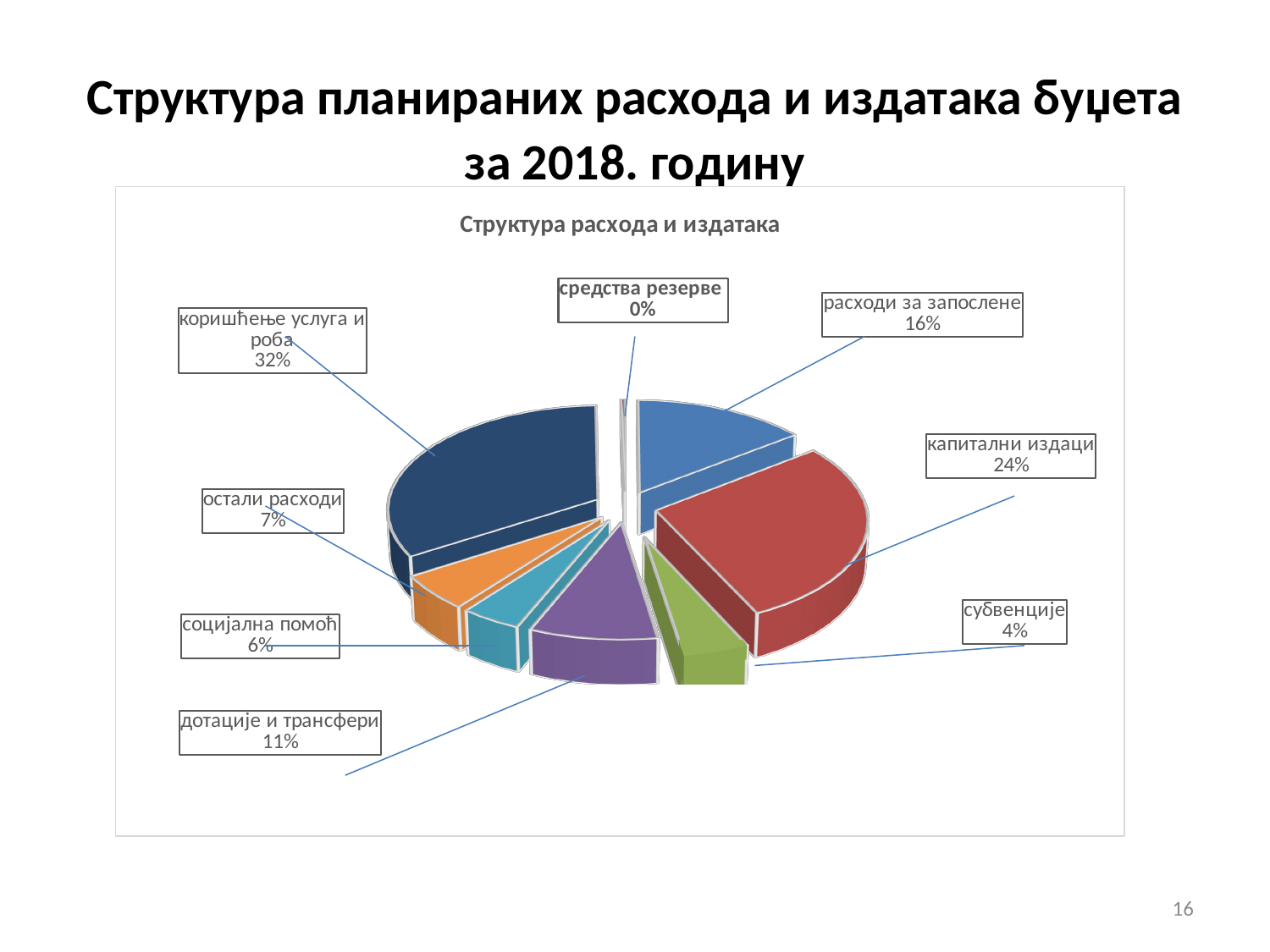
What share of the pie does дотације и трансфери have? 11% How many categories are shown in the pie chart? 8 What is the difference in percentage points between капитални издаци and расходи за запослене? 8 Which category has the largest share of the pie? коришћење услуга и роба What type of chart is shown on the slide? pie chart What is the title of the chart? Структура расхода и издатака Which category has the smallest share of the pie? средства резерве What share of the pie does расходи за запослене have? 16% What share of the pie does коришћење услуга и роба have? 32%